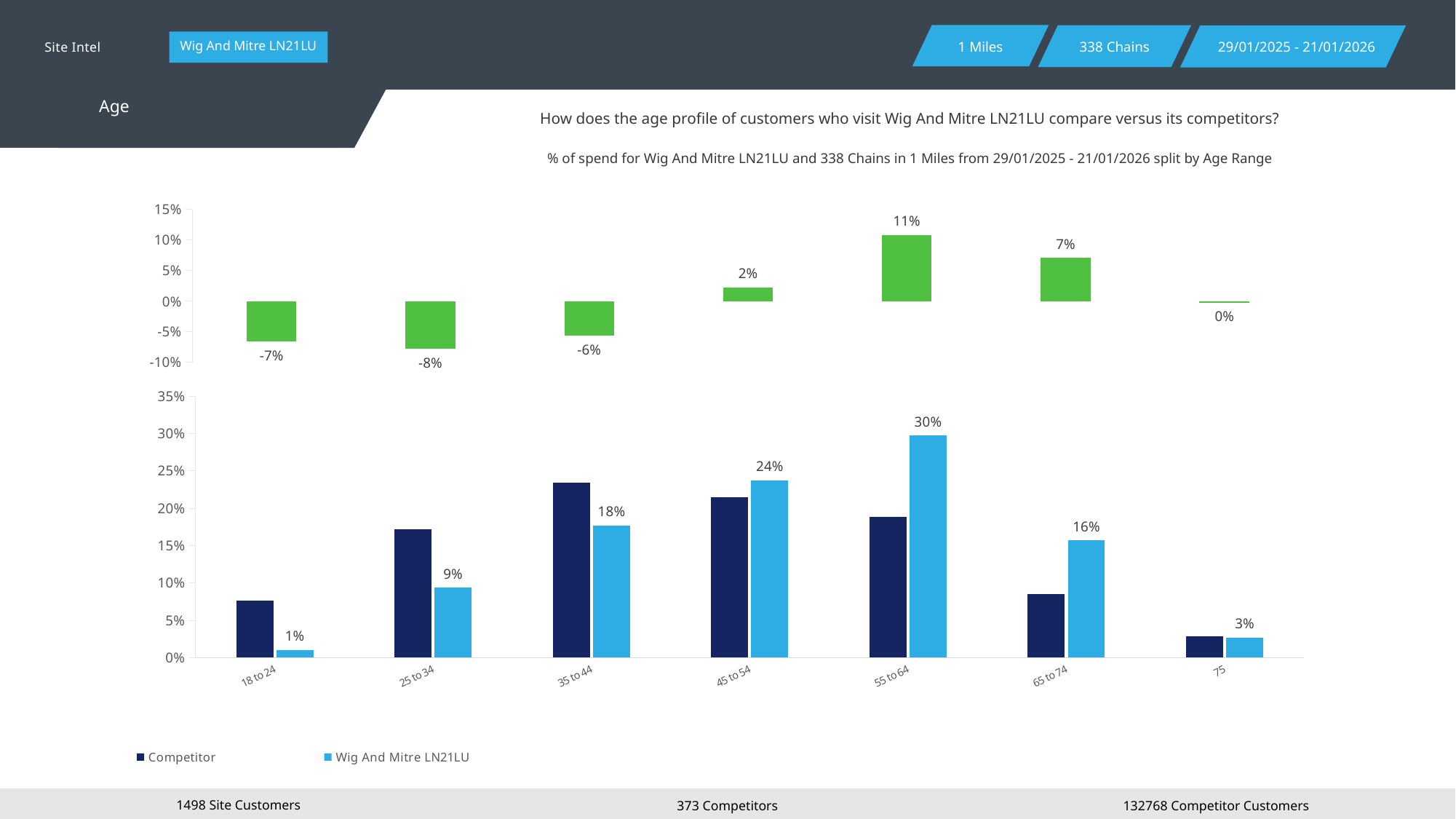
In the top chart, which age range has the lowest value? 25 to 34 In the bottom chart, is the Competitor value for 45 to 54 greater or less than 20%? greater In the top chart, what is the value shown for the 55 to 64 age range? 11% In the bottom chart, what is the value for Wig And Mitre LN21LU in the 18 to 24 age range? 1% In the bottom chart, for the 35 to 44 age range, which is larger: the Competitor bar or the Wig And Mitre LN21LU bar? Competitor How many series does the legend of the bottom chart list? 2 In the top chart, what is the value shown for the 25 to 34 age range? -8% What type of chart is the bottom chart? Bar chart In the bottom chart, what is the difference between the Wig And Mitre LN21LU values for 55 to 64 and 45 to 54? 6% How many age range categories are shown on the x axis of the bottom chart? 7 In the bottom chart, which age range has the highest value for Wig And Mitre LN21LU? 55 to 64 In the bottom chart, what is the value for Wig And Mitre LN21LU in the 55 to 64 age range? 30%